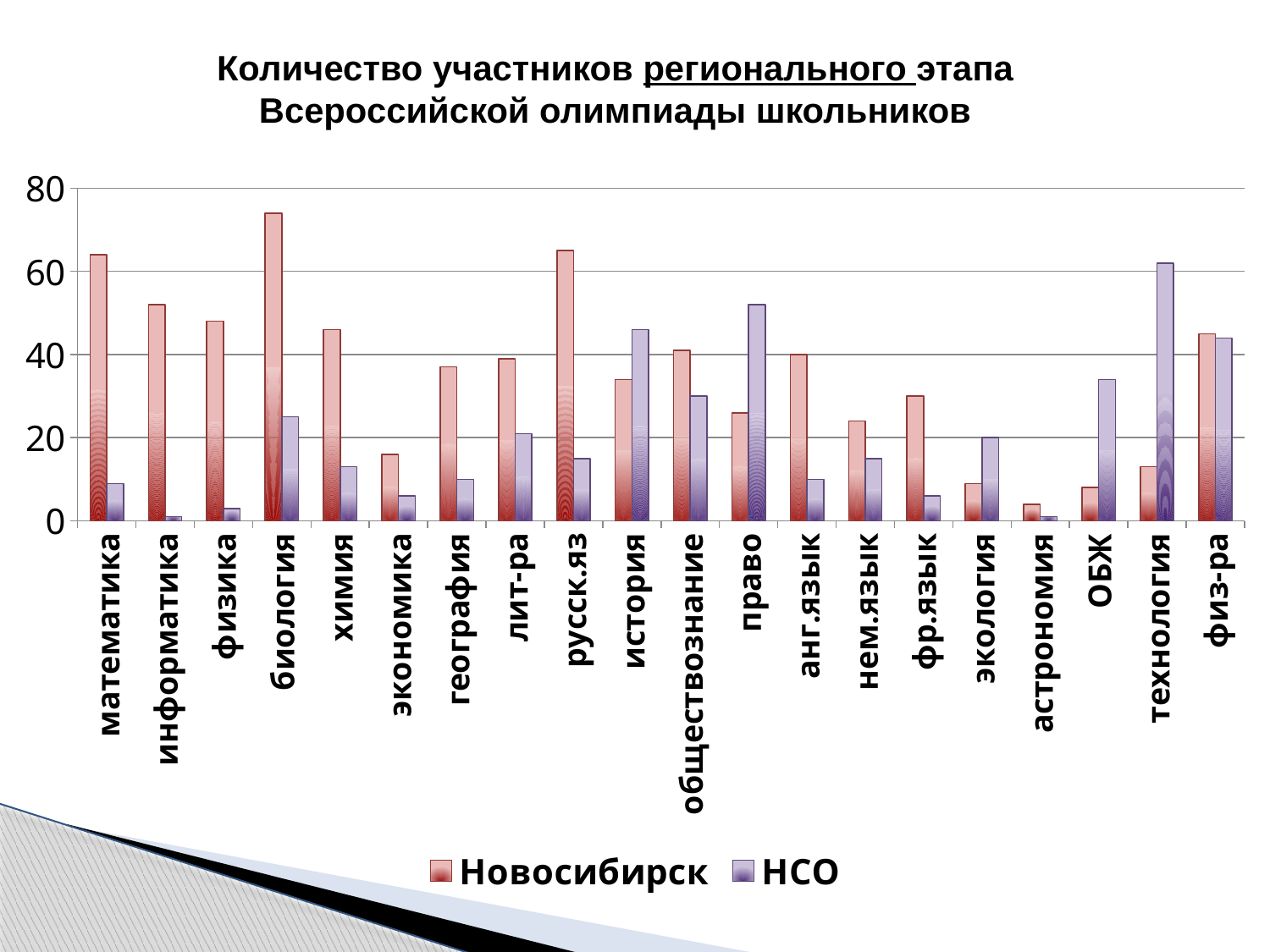
How many subject categories are shown on the x axis? 20 Which subject has the highest value for Новосибирск? биология For право, which series has the larger value, Новосибирск or НСО? НСО Which subject has the lowest value for Новосибирск? астрономия Is the value for Новосибирск in экономика greater or less than 20? less Which subject has the highest value for НСО? технология Is the value for Новосибирск in математика greater or less than 60? greater Is the value for НСО in право greater or less than 40? greater For математика, which series has the larger value, Новосибирск or НСО? Новосибирск How many series does the legend list? 2 What kind of chart is shown on the slide? bar chart Which series is shown in red bars? Новосибирск